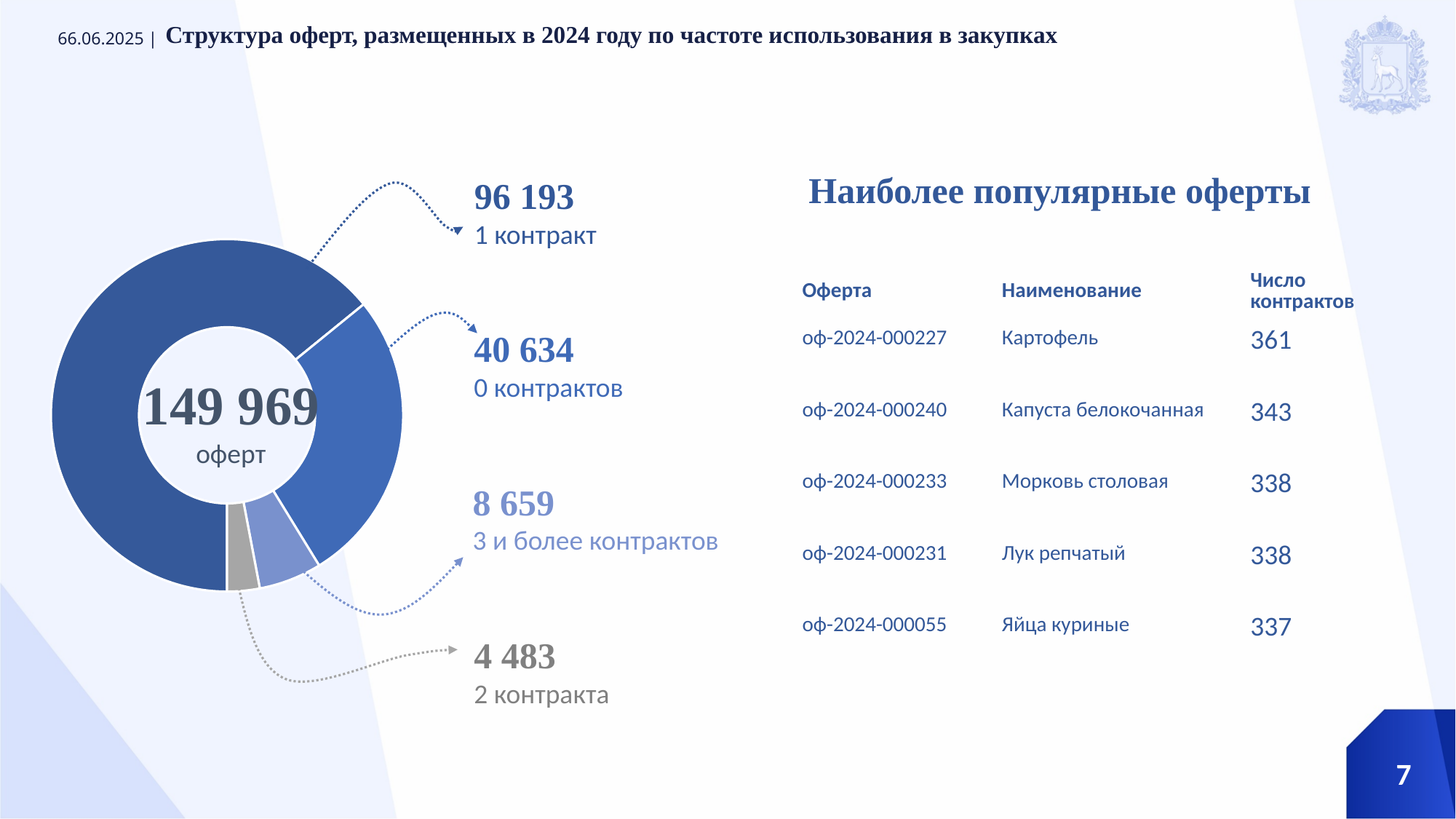
What total number of offers is shown in the centre of the donut chart? 149 969 Which category in the donut chart has the smallest number of offers? 2 контракта What colour is the segment for offers with 2 contracts in the donut chart? Grey How many offers with 3 or more contracts are shown in the donut chart? 8 659 What is the difference between the number of offers with 1 contract and the number with 0 contracts? 55 559 How many offers with 0 contracts are shown in the donut chart? 40 634 How many offers with 1 contract are shown in the donut chart? 96 193 How many categories does the donut chart have? 4 Which category in the donut chart has the largest number of offers? 1 контракт Which is larger: the number of offers with 3 or more contracts or the number with 2 contracts? 3 и более контрактов What type of chart is shown on the left of the slide? Donut (pie) chart How many offers with 2 contracts are shown in the donut chart? 4 483